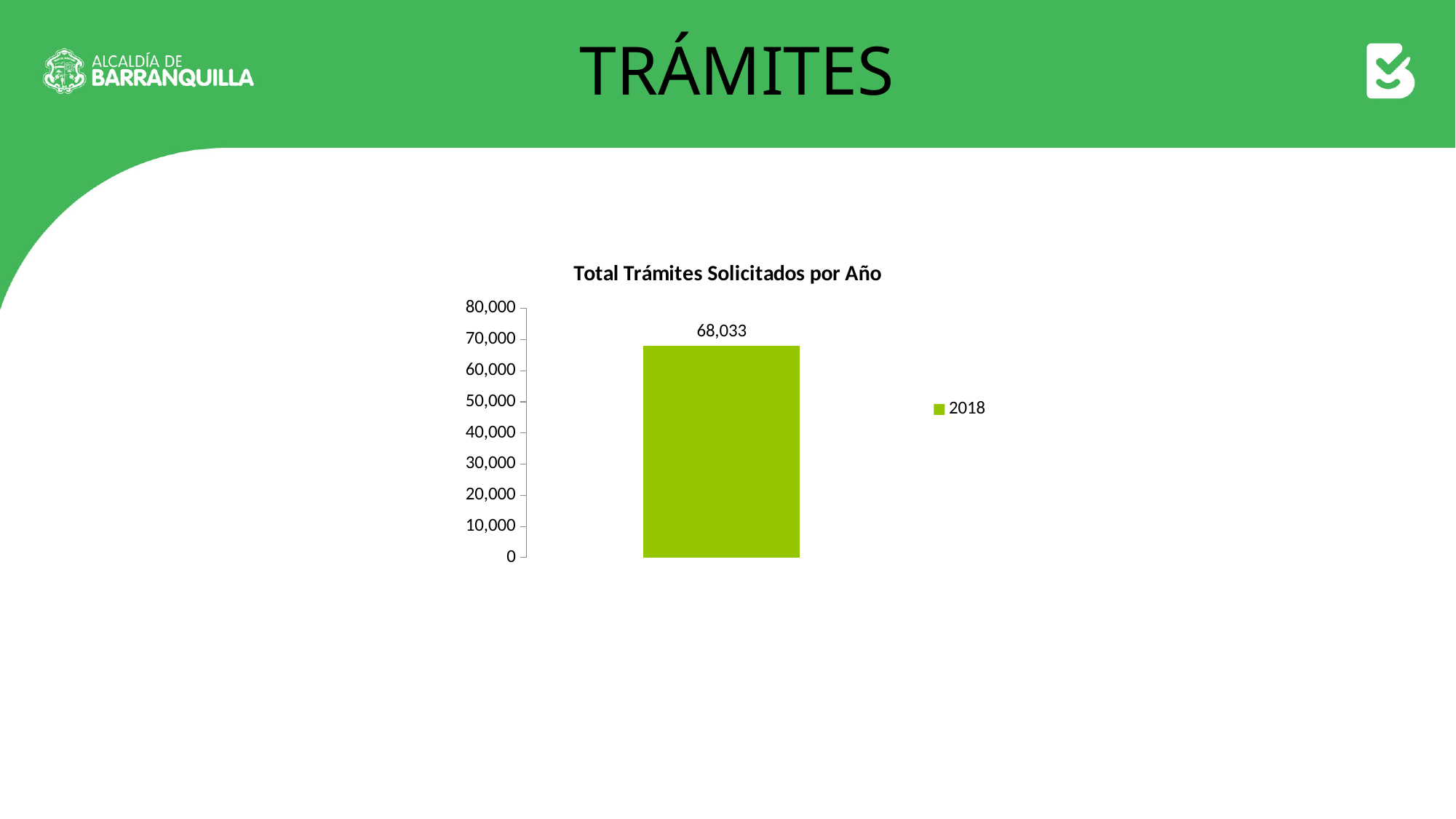
Is the value for 2018 greater or less than 70,000? less What series name appears in the chart legend? 2018 Is the value for 2018 greater or less than 60,000? greater What is the title of the chart? Total Trámites Solicitados por Año What kind of chart is shown on the slide? bar chart How many series does the legend list? 1 How many bars are plotted in the chart? 1 What is the value for 2018 in the chart? 68,033 What is the highest value shown on the vertical axis of the chart? 80,000